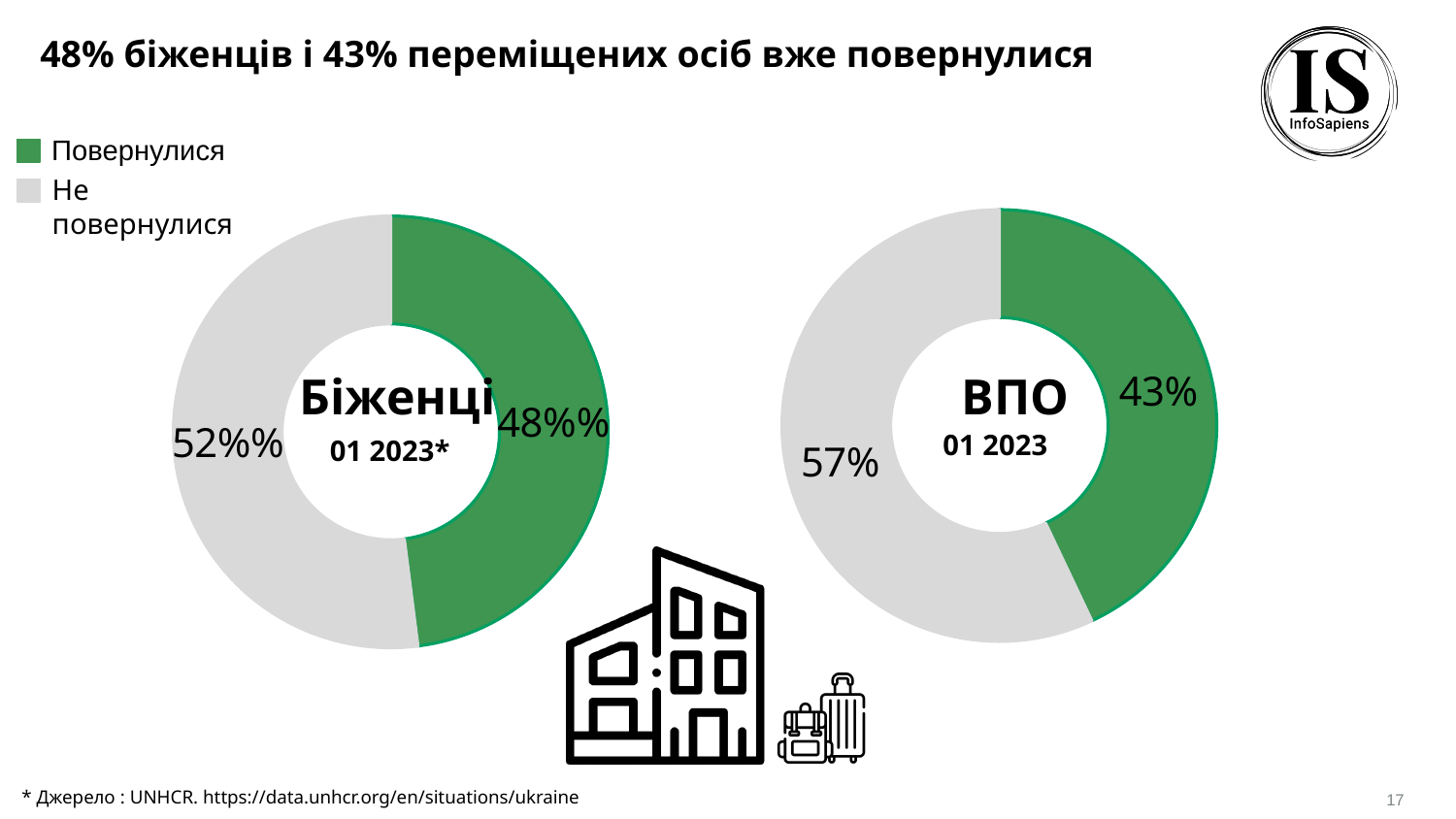
In the 'ВПО' chart, what is the difference between the Не повернулися and Повернулися shares? 14% How many entries does the legend list? 2 Which colour represents Повернулися in the legend? Green In the 'Біженці' chart, which slice is the largest? Не повернулися In the 'ВПО' chart, what share of internally displaced persons have returned (Повернулися)? 43% In the 'Біженці' chart, what share of refugees have returned (Повернулися)? 48% In the 'ВПО' chart, what share have not returned (Не повернулися)? 57% In the 'Біженці' chart, what share have not returned (Не повернулися)? 52% Which chart shows a higher share of Повернулися: 'Біженці' or 'ВПО'? Біженці How many slices does the 'ВПО' chart have? 2 In the 'ВПО' chart, which slice is larger: Повернулися or Не повернулися? Не повернулися What type of chart is used on this slide? Donut (pie) chart